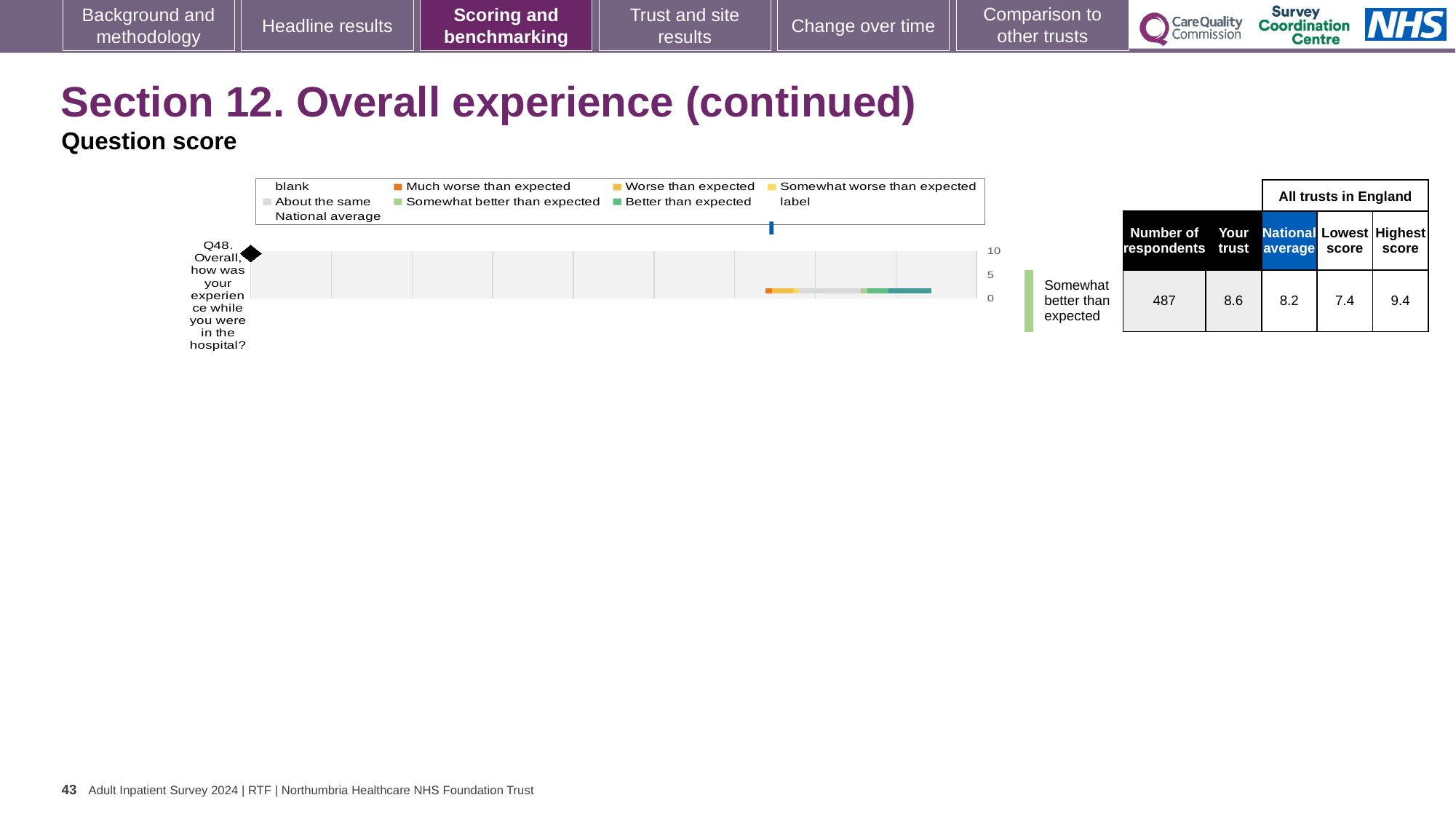
Which is larger for Q48, the 'Your trust' score or the National average? Your trust How many respondents answered Q48 according to the table? 487 According to the table, what is the Lowest score among all trusts in England for Q48? 7.4 What benchmark category is the trust's Q48 score assigned to? Somewhat better than expected What is the difference between the 'Your trust' score and the National average for Q48? 0.4 How many questions (categories) are plotted in the chart? 1 What is the highest value shown on the chart's axis? 10 Which question is plotted in the chart? Q48. Overall, how was your experience while you were in the hospital? What kind of chart is shown on the slide? bar chart According to the table, what is the National average score for Q48? 8.2 According to the table, what is the Highest score among all trusts in England for Q48? 9.4 According to the table, what is the 'Your trust' score for Q48? 8.6